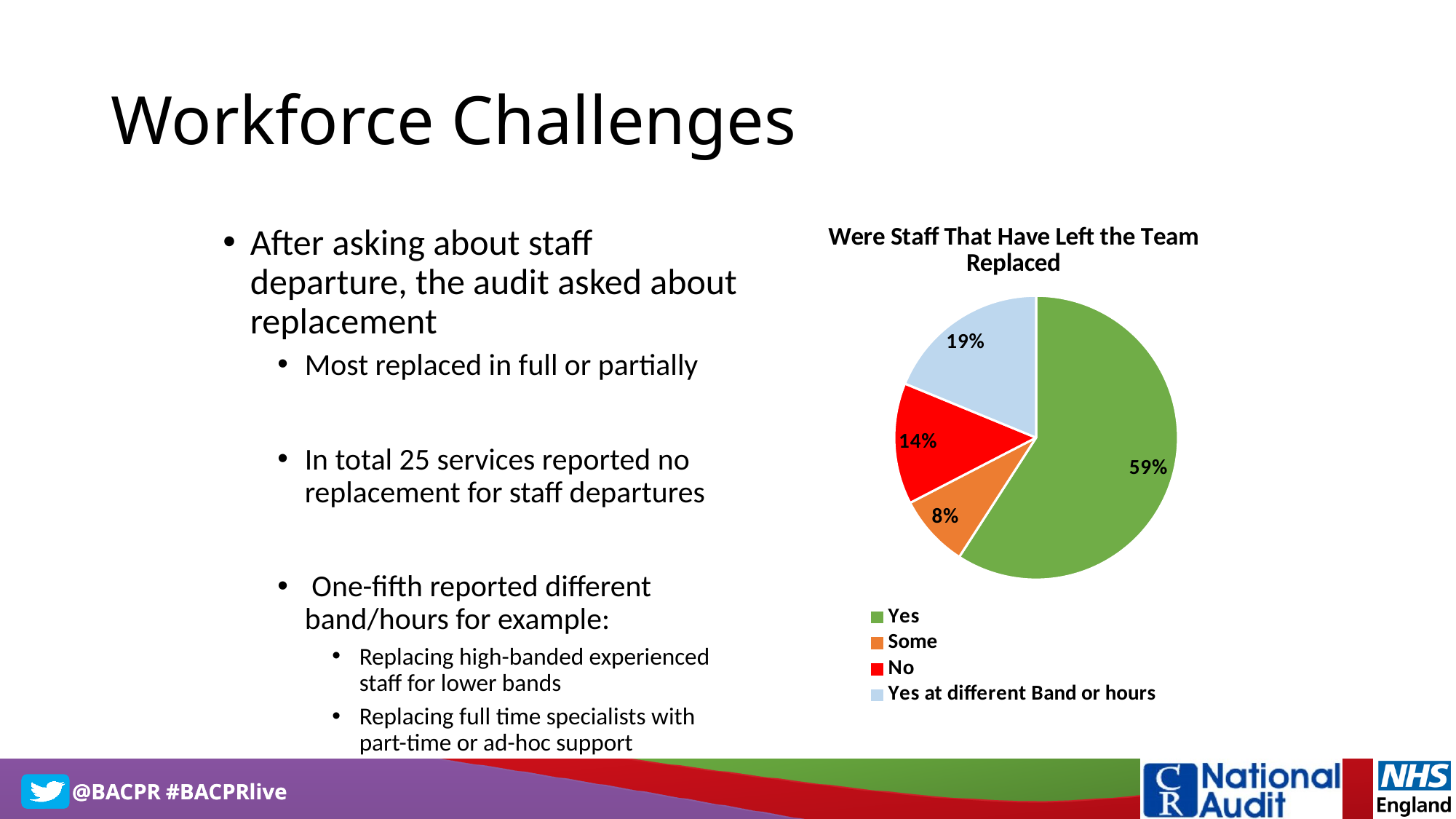
Which category has the largest slice of the pie? Yes What colour is the "No" slice of the pie? red What is the difference in percentage points between the "Yes" slice and the "No" slice? 45 What percentage of the pie is labelled "Yes"? 59% What kind of chart is shown on the slide? pie chart How many categories does the legend list? 4 Which slice is larger, "No" or "Yes at different Band or hours"? Yes at different Band or hours What percentage of the pie is labelled "Some"? 8% What percentage of the pie is labelled "Yes at different Band or hours"? 19% What percentage of the pie is labelled "No"? 14% What is the title of the chart? Were Staff That Have Left the Team Replaced Which category has the smallest slice of the pie? Some